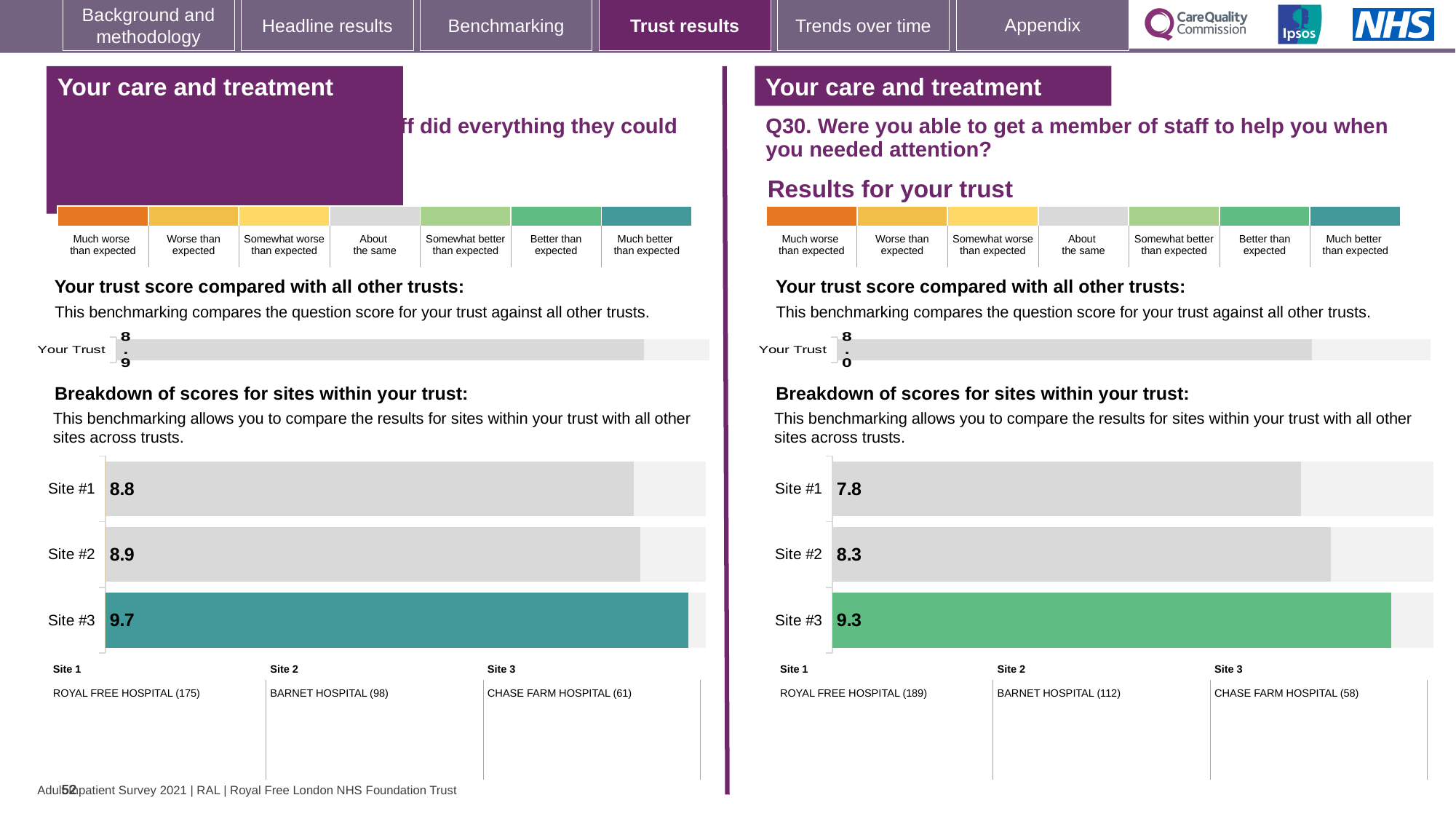
On the right-hand (Q30) site breakdown chart, which is larger: the score for Site #2 or Site #1? Site #2 How many sites are shown on the right-hand (Q30) 'Breakdown of scores for sites within your trust' chart? 3 On the right-hand (Q30) site breakdown chart, what is the difference between the scores for Site #3 and Site #1? 1.5 On the right-hand (Q30) site breakdown chart, which site's bar is coloured green rather than grey? Site #3 On the right-hand (Q30) 'Breakdown of scores for sites within your trust' chart, what is the score for Site #1? 7.8 On the left-hand site breakdown chart, what is the difference between the scores for Site #3 and Site #2? 0.8 On the left-hand 'Breakdown of scores for sites within your trust' chart, what is the score for Site #3? 9.7 On the left-hand 'Your trust score compared with all other trusts' chart, what is the score for Your Trust? 8.9 What kind of chart is the left-hand 'Breakdown of scores for sites within your trust' chart? Bar chart On the right-hand (Q30) 'Your trust score compared with all other trusts' chart, what is the score for Your Trust? 8.0 On the left-hand 'Breakdown of scores for sites within your trust' chart, which site has the lowest score? Site #1 On the right-hand (Q30) 'Breakdown of scores for sites within your trust' chart, which site has the highest score? Site #3